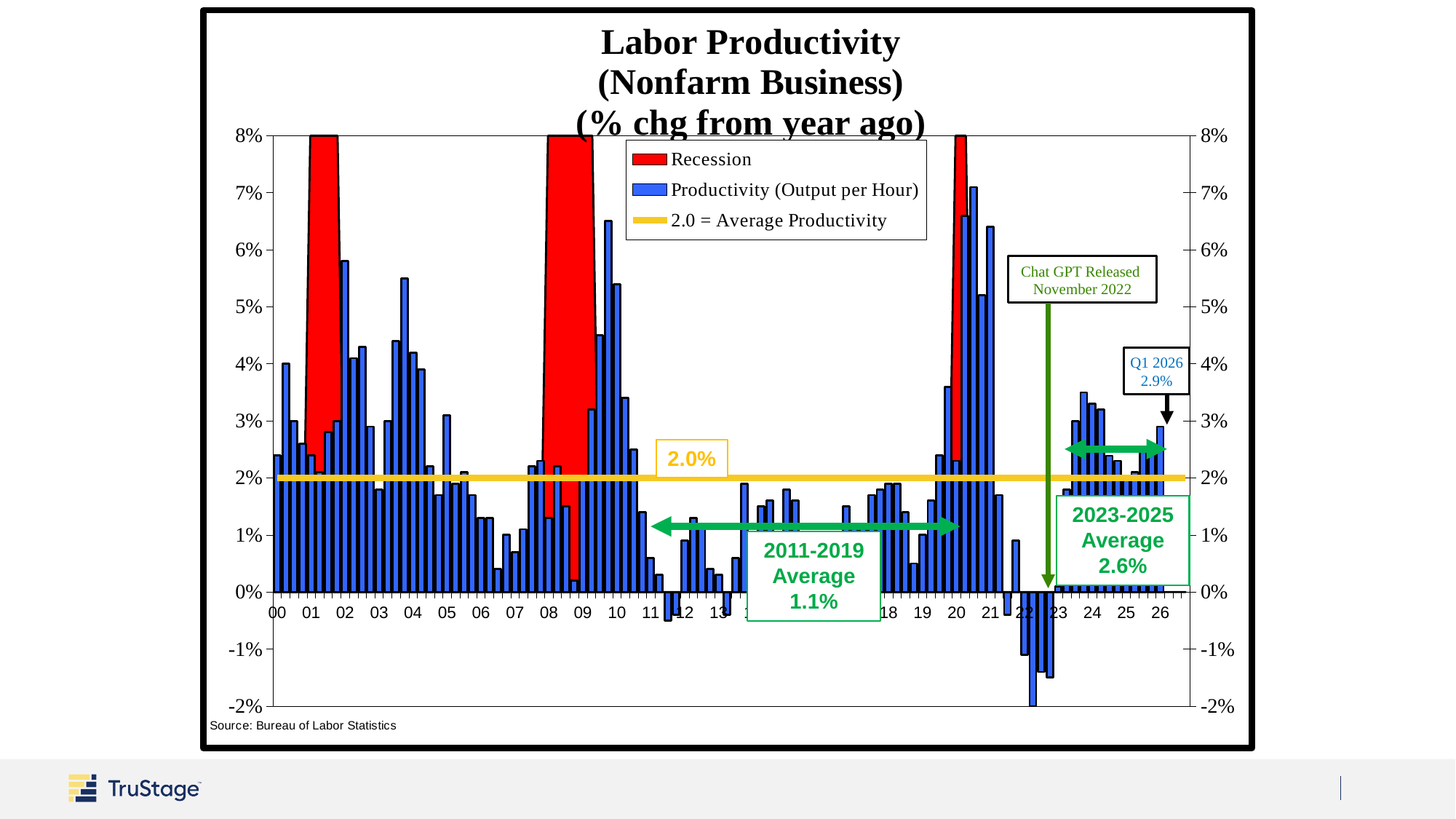
What event does the annotation say happened in November 2022? Chat GPT Released How many entries does the legend list? 3 What is the 2011-2019 average productivity shown on the chart? 1.1% Are the productivity bars in 2022 greater or less than 0%? less What is the labor productivity value labeled for Q1 2026? 2.9% Is the Q1 2026 value greater or less than 2%? greater What is the 2023-2025 average productivity shown on the chart? 2.6% What value does the yellow horizontal line represent? 2.0% In which year does the lowest productivity bar occur? 2022 What is the difference between the 2023-2025 average and the 2011-2019 average? 1.5 percentage points What kind of chart is shown on the slide? Bar chart Which is larger, the 2011-2019 average or the 2023-2025 average? 2023-2025 average